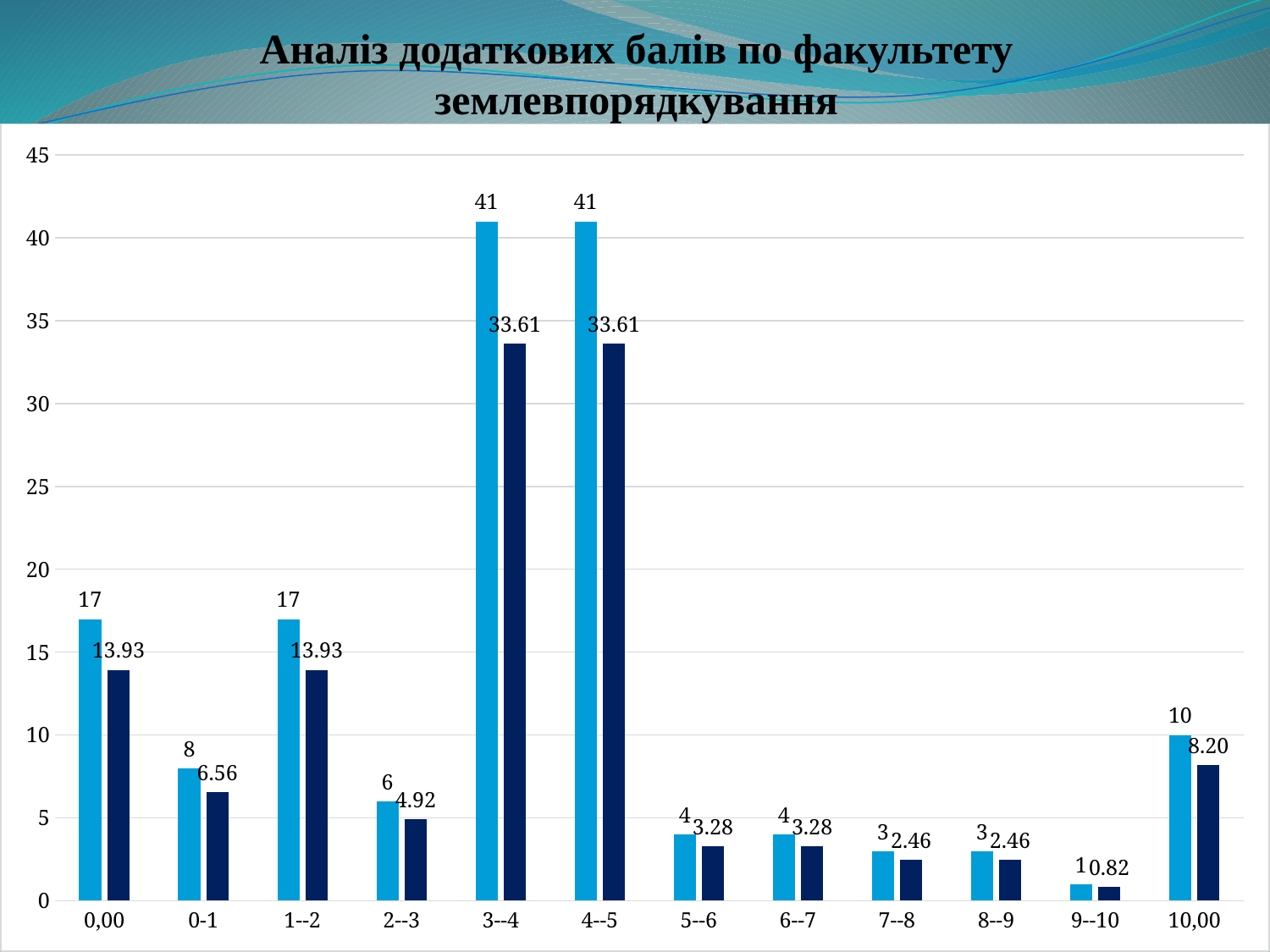
What is the value of the light blue bar for the category 9--10? 1 Which category has the lowest light blue bar? 9--10 What is the difference between the light blue bar for 4--5 and the light blue bar for 1--2? 24 How many categories are shown on the x axis? 12 Which is larger: the light blue bar for 2--3 or the light blue bar for 10,00? 10,00 What is the value of the light blue bar for the category 3--4? 41 What kind of chart is shown on the slide? bar chart What is the value of the dark navy bar for the category 10,00? 8.20 What is the title of the chart? Аналіз додаткових балів по факультету землевпорядкування Is the dark navy bar for 3--4 greater or less than 30? greater What is the difference between the dark navy bar for 0,00 and the dark navy bar for 0-1? 7.37 What is the value of the dark navy bar for the category 0-1? 6.56